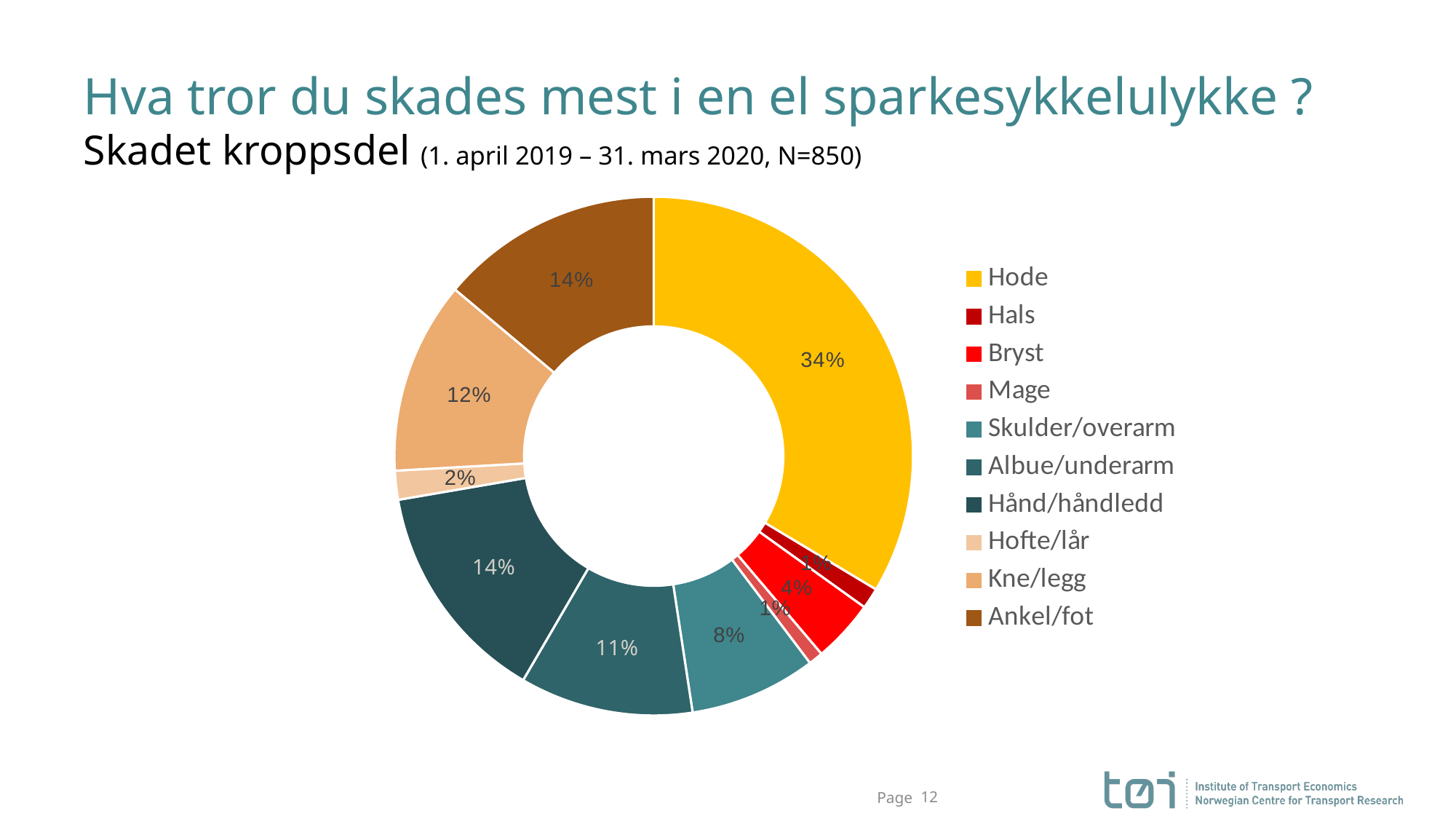
What is the value shown for Bryst? 4% How many categories does the legend list? 10 What is the difference between the shares for Hode and Hånd/håndledd? 20 percentage points Which category has the largest share of the pie? Hode What kind of chart is shown on the slide? Pie chart (donut) What colour is the Hode slice in the chart? Yellow What is the value shown for Kne/legg? 12% What is the value shown for Skulder/overarm? 8% What is the value shown for Albue/underarm? 11% Which is larger, the share for Kne/legg or the share for Skulder/overarm? Kne/legg What share of the pie does Hode account for? 34% What is the value shown for Hofte/lår? 2%